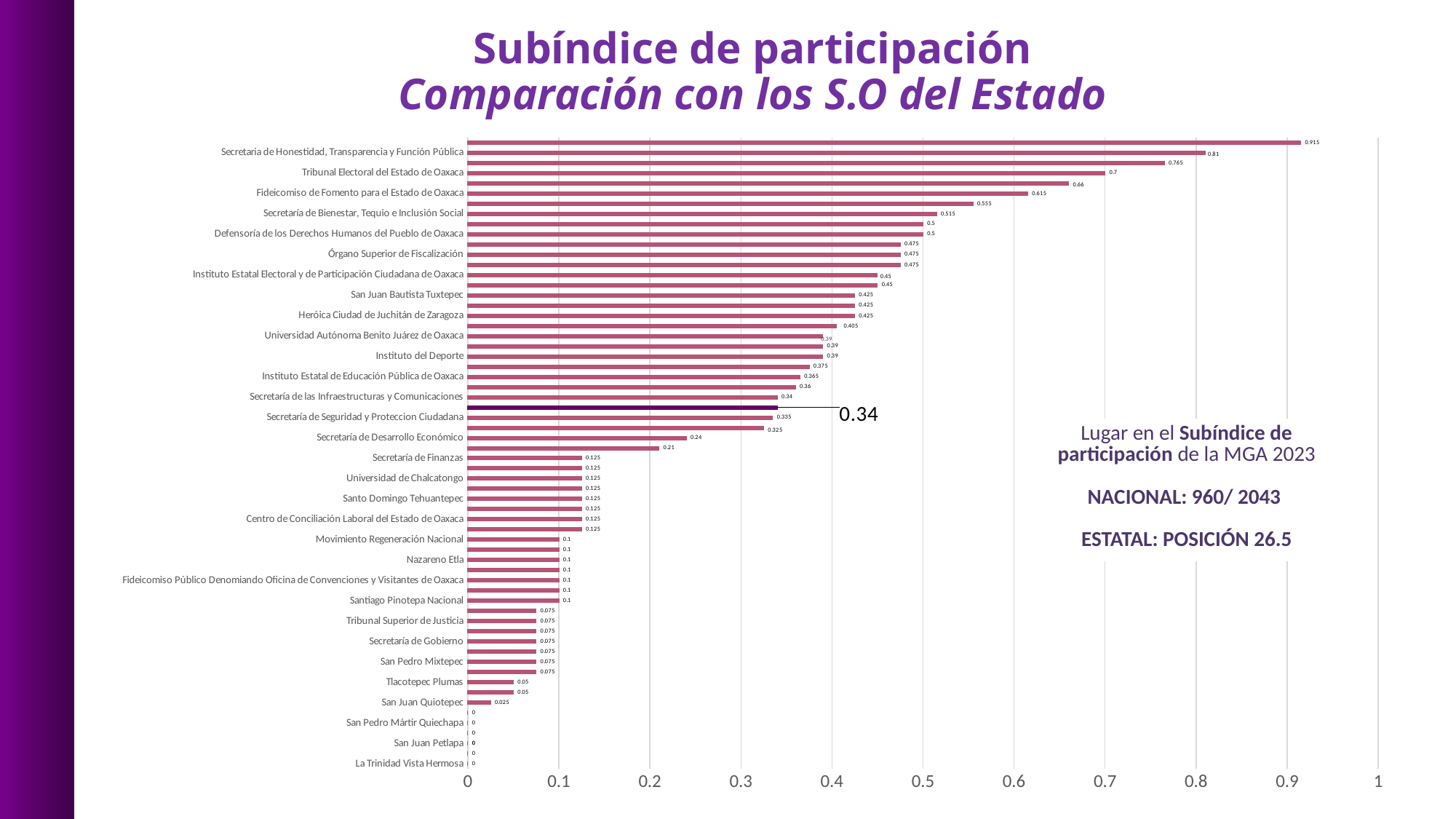
What is the maximum value shown on the horizontal axis? 1 Do the bar values increase or decrease going from the top of the chart to the bottom? decrease What value is labelled on the highlighted (dark purple) bar in the chart? 0.34 Is the value of the highlighted bar greater or less than 0.3? greater What is the highest value shown in the chart? 0.915 What is the difference between the highest value (0.915) and the highlighted bar's value (0.34)? 0.575 What is the main title of the chart slide? Subíndice de participación What is the lowest value shown in the chart? 0 What is the second highest value labelled in the chart? 0.81 What is the difference between the highest value (0.915) and the second highest value (0.81)? 0.105 Is the highest value in the chart greater or less than 0.9? greater What type of chart is shown on the slide? Bar chart